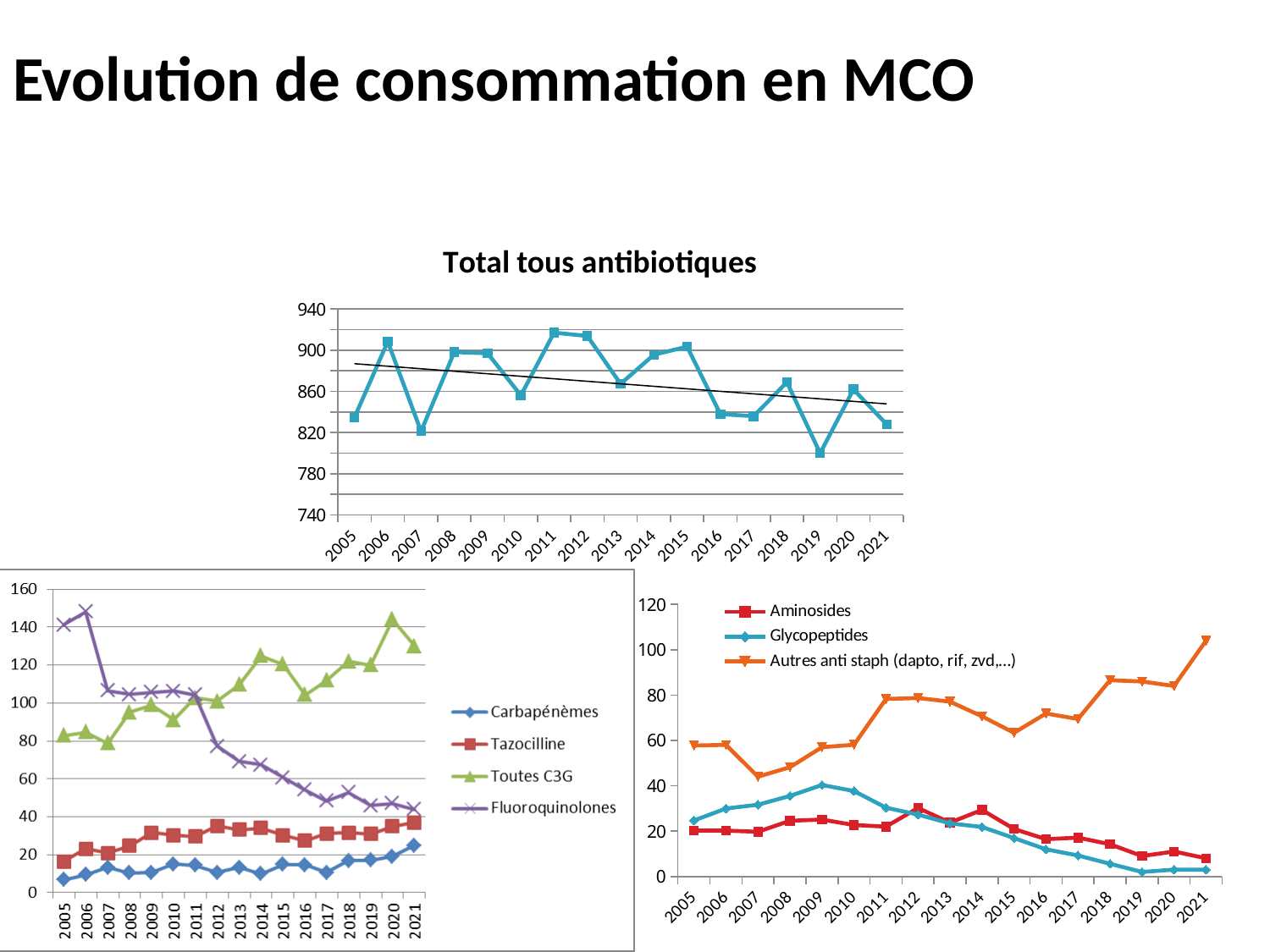
In the 'Total tous antibiotiques' chart, which year has the lowest value? 2019 In the bottom-left chart, which is larger in 2021: Toutes C3G or Fluoroquinolones? Toutes C3G How many series does the legend of the bottom-left chart list? 4 In the 'Total tous antibiotiques' chart, does the black trend line rise or fall from 2005 to 2021? fall In the bottom-right chart, is the value for 'Autres anti staph (dapto, rif, zvd,...)' in 2021 greater or less than 100? greater In the bottom-left chart, do the Fluoroquinolones values rise or fall overall from 2005 to 2021? fall In the 'Total tous antibiotiques' chart, is the value for 2006 greater or less than 900? greater In the bottom-left chart, is the value for Fluoroquinolones in 2006 greater or less than 140? greater How many series does the legend of the bottom-right chart list? 3 How many years are plotted on the x axis of the 'Total tous antibiotiques' chart? 17 What kind of chart is the 'Total tous antibiotiques' chart? line chart